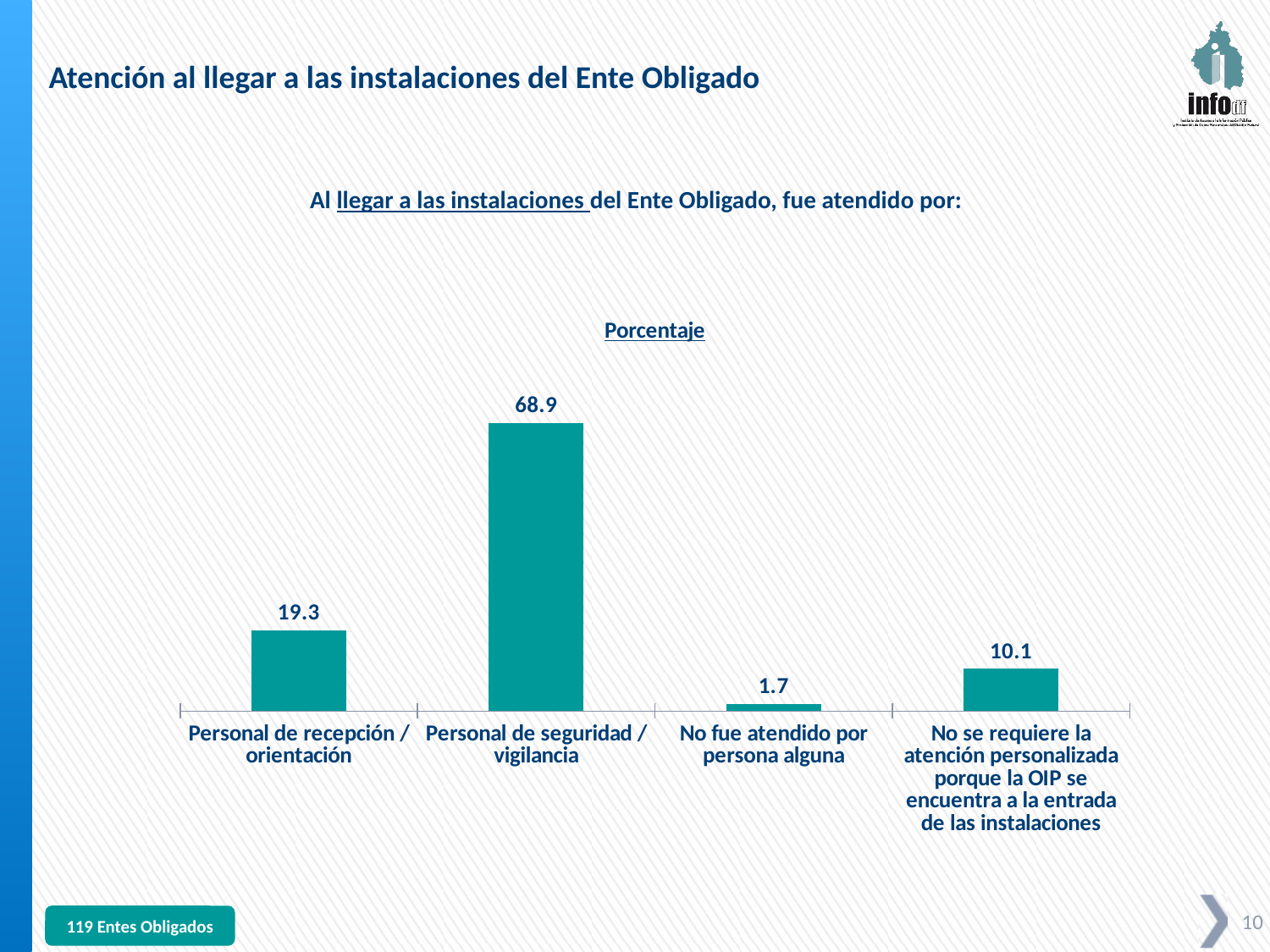
Which category has the highest value? Personal de seguridad / vigilancia What is the value for "No fue atendido por persona alguna"? 1.7 Which is larger: the value for "Personal de recepción / orientación" or the value for "No fue atendido por persona alguna"? Personal de recepción / orientación What is the value for "Personal de recepción / orientación"? 19.3 What is the title of the chart? Porcentaje How many categories are shown in the chart? 4 What kind of chart is shown on the slide? Bar chart What is the difference between the values for "Personal de recepción / orientación" and "No se requiere la atención personalizada porque la OIP se encuentra a la entrada de las instalaciones"? 9.2 What is the difference between the values for "Personal de seguridad / vigilancia" and "Personal de recepción / orientación"? 49.6 What is the value for "Personal de seguridad / vigilancia"? 68.9 What is the value for "No se requiere la atención personalizada porque la OIP se encuentra a la entrada de las instalaciones"? 10.1 Which category has the lowest value? No fue atendido por persona alguna